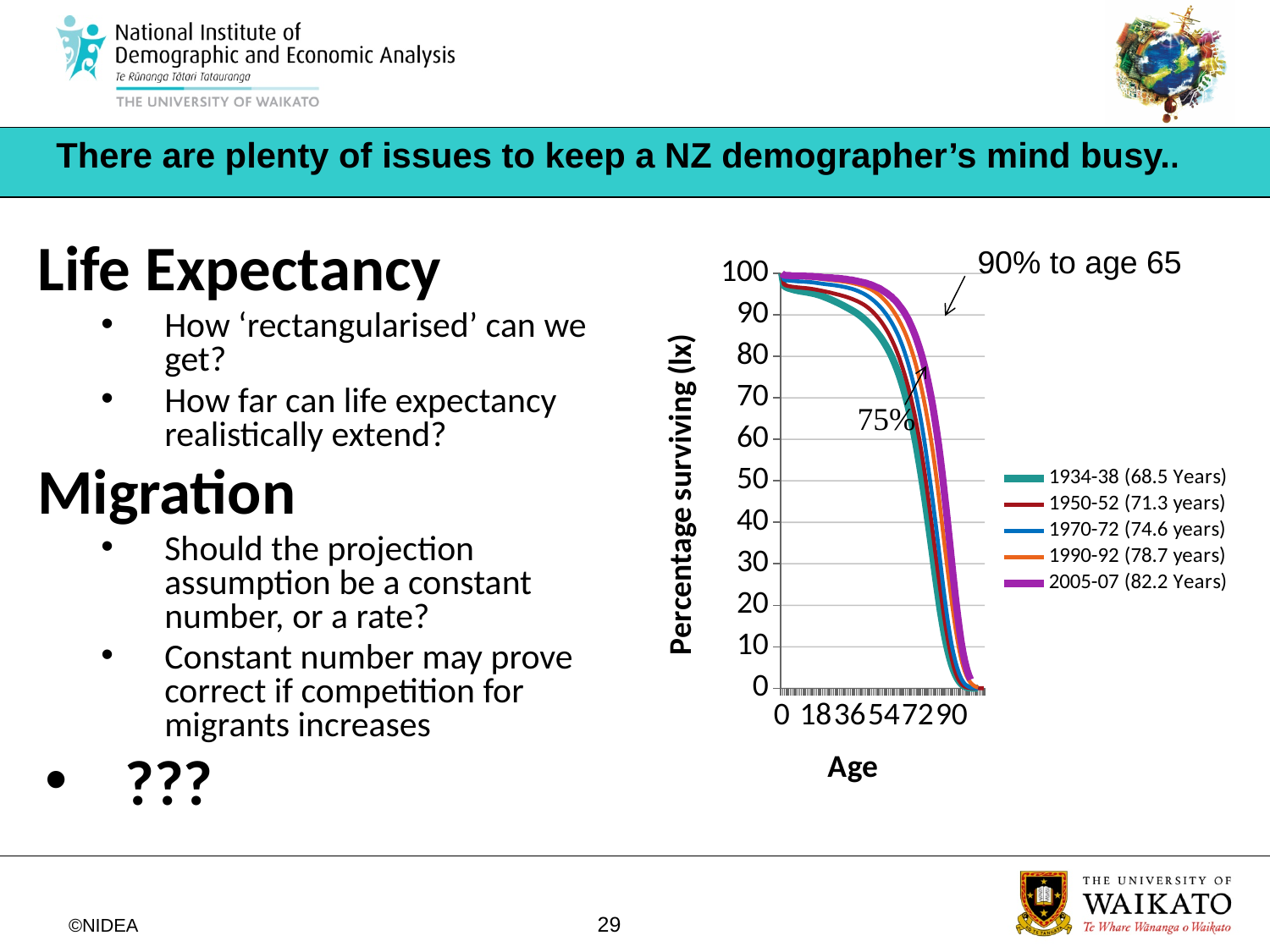
Is the percentage surviving for the 1934-38 series at age 90 greater or less than 30? less What is the title of the chart's horizontal axis? Age Is the percentage surviving for the 2005-07 series at age 18 greater or less than 90? greater According to the legend, what life expectancy is given for the 1934-38 series? 68.5 Years Which series in the legend has the lowest life expectancy in years? 1934-38 (68.5 Years) At age 72, which series has the higher percentage surviving, 2005-07 or 1934-38? 2005-07 What kind of chart is shown on the slide? line chart Do the percentage surviving values rise or fall as age increases along the x axis? fall According to the legend, what life expectancy is given for the 2005-07 series? 82.2 Years How many series does the chart's legend list? 5 Which series in the legend has the highest life expectancy in years? 2005-07 (82.2 Years) What is the title of the chart's vertical axis? Percentage surviving (lx)